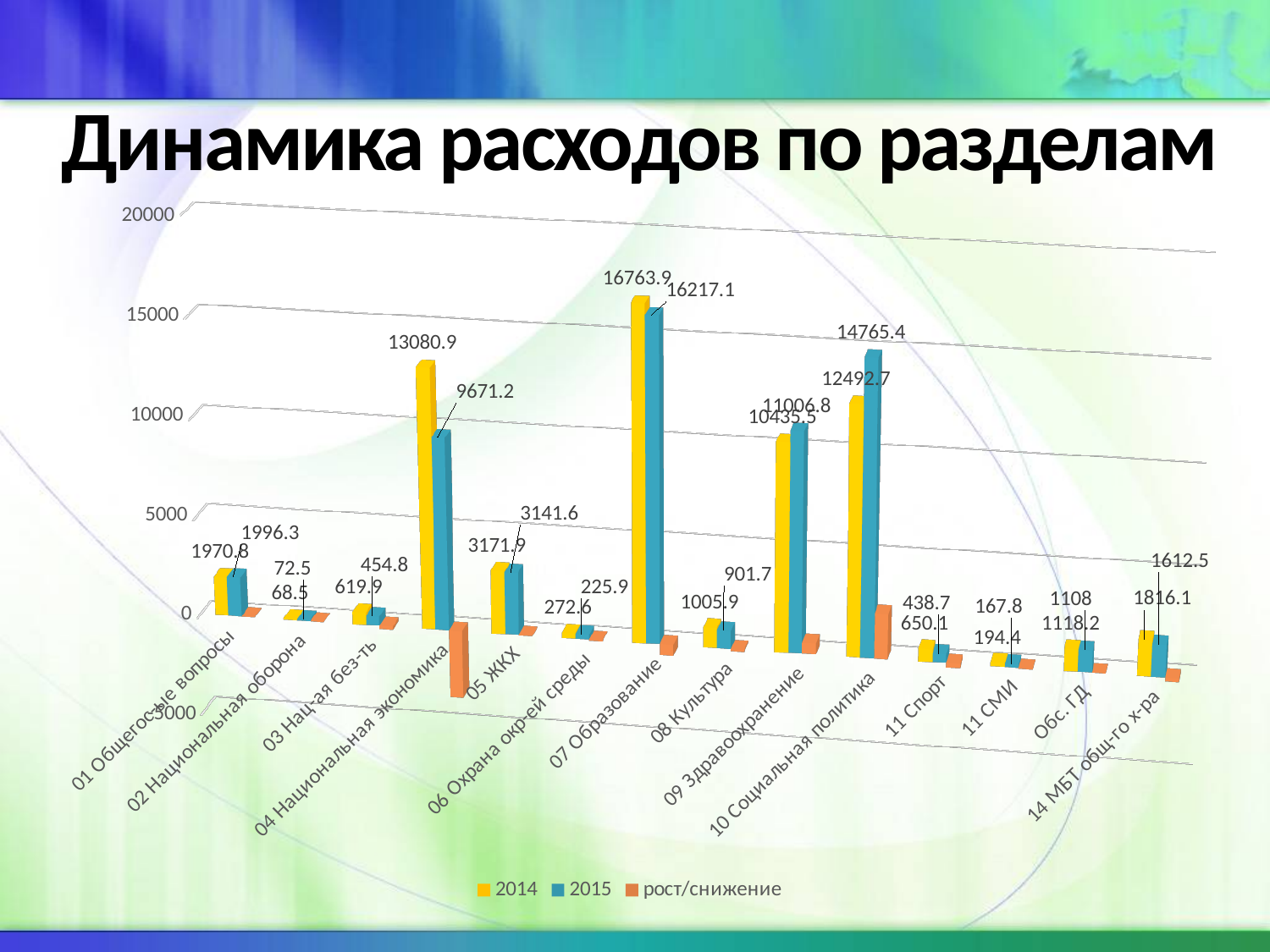
How many series does the legend list? 3 What kind of chart is shown on the slide? Bar chart What is the difference between the 2014 and 2015 values for 04 Национальная экономика? 3409.7 Which category has the lowest 2015 value? 02 Национальная оборона What is the 2014 value for 02 Национальная оборона? 68.5 What is the difference between the 2015 and 2014 values for 10 Социальная политика? 2272.7 Which category has the highest 2014 value? 07 Образование How many categories are shown on the x axis? 14 Which is larger for 09 Здравоохранение: the 2014 value or the 2015 value? 2015 What is the 2014 value for 07 Образование? 16763.9 What is the 2015 value for 10 Социальная политика? 14765.4 What is the 2015 value for 04 Национальная экономика? 9671.2